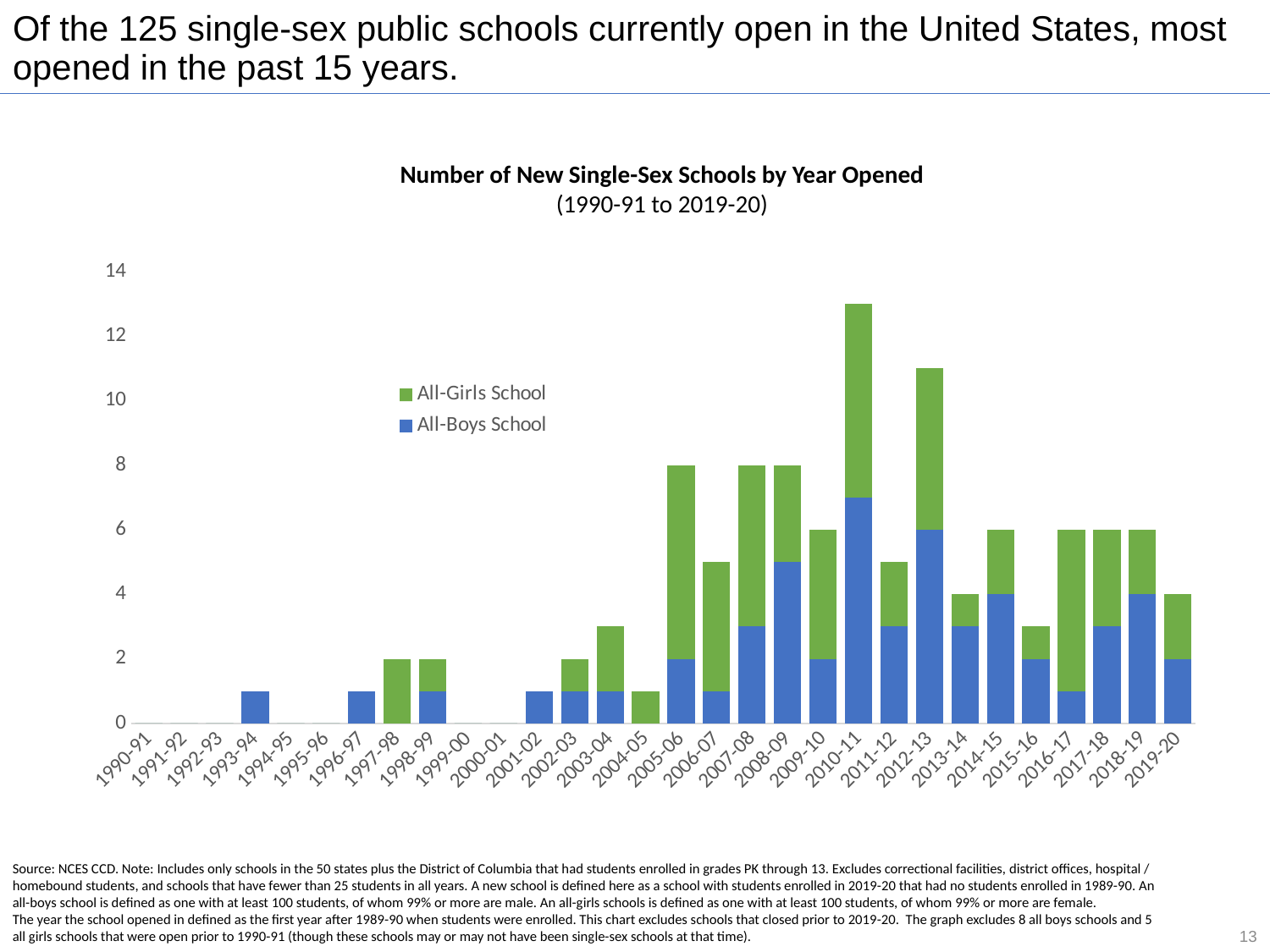
How many series does the legend list? 2 Which colour represents All-Girls School in the chart? Green What is the total number of new single-sex schools opened in 2009-10? 6 How many All-Boys Schools opened in 2012-13? 6 What kind of chart is shown on the slide? Bar chart Is the total number of new single-sex schools in 2010-11 greater or less than 12? greater How many school years are shown on the x axis? 30 What is the total number of new single-sex schools opened in 2005-06? 8 What is the difference between the total number of new single-sex schools in 2005-06 and in 2009-10? 2 Which year had a larger total of new single-sex schools, 2012-13 or 2013-14? 2012-13 Which school year has the highest total number of new single-sex schools? 2010-11 How many All-Boys Schools opened in 2014-15? 4